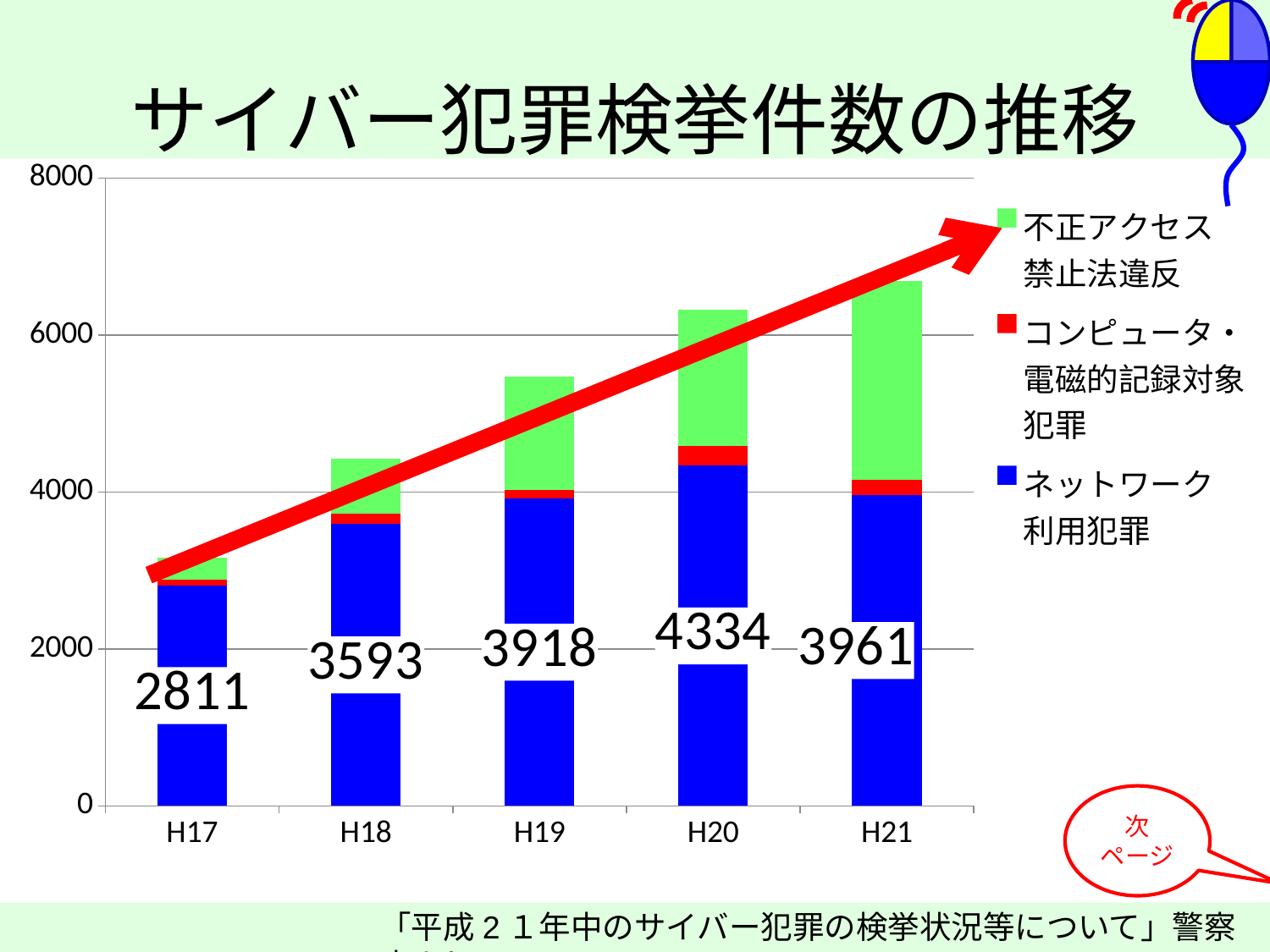
What is the value of ネットワーク利用犯罪 for H17? 2811 What is the title of the chart? サイバー犯罪検挙件数の推移 What kind of chart is shown on the slide? stacked bar chart How many series does the legend list? 3 What is the difference between the ネットワーク利用犯罪 values for H20 and H21? 373 How many categories (years) are shown on the x axis? 5 In which year is the value of ネットワーク利用犯罪 highest? H20 Is the total height of the H21 bar greater or less than 6000? greater Which is larger, the ネットワーク利用犯罪 value for H18 or for H19? H19 In which year is the value of ネットワーク利用犯罪 lowest? H17 What is the value of ネットワーク利用犯罪 for H20? 4334 Is the total height of the H17 bar greater or less than 4000? less